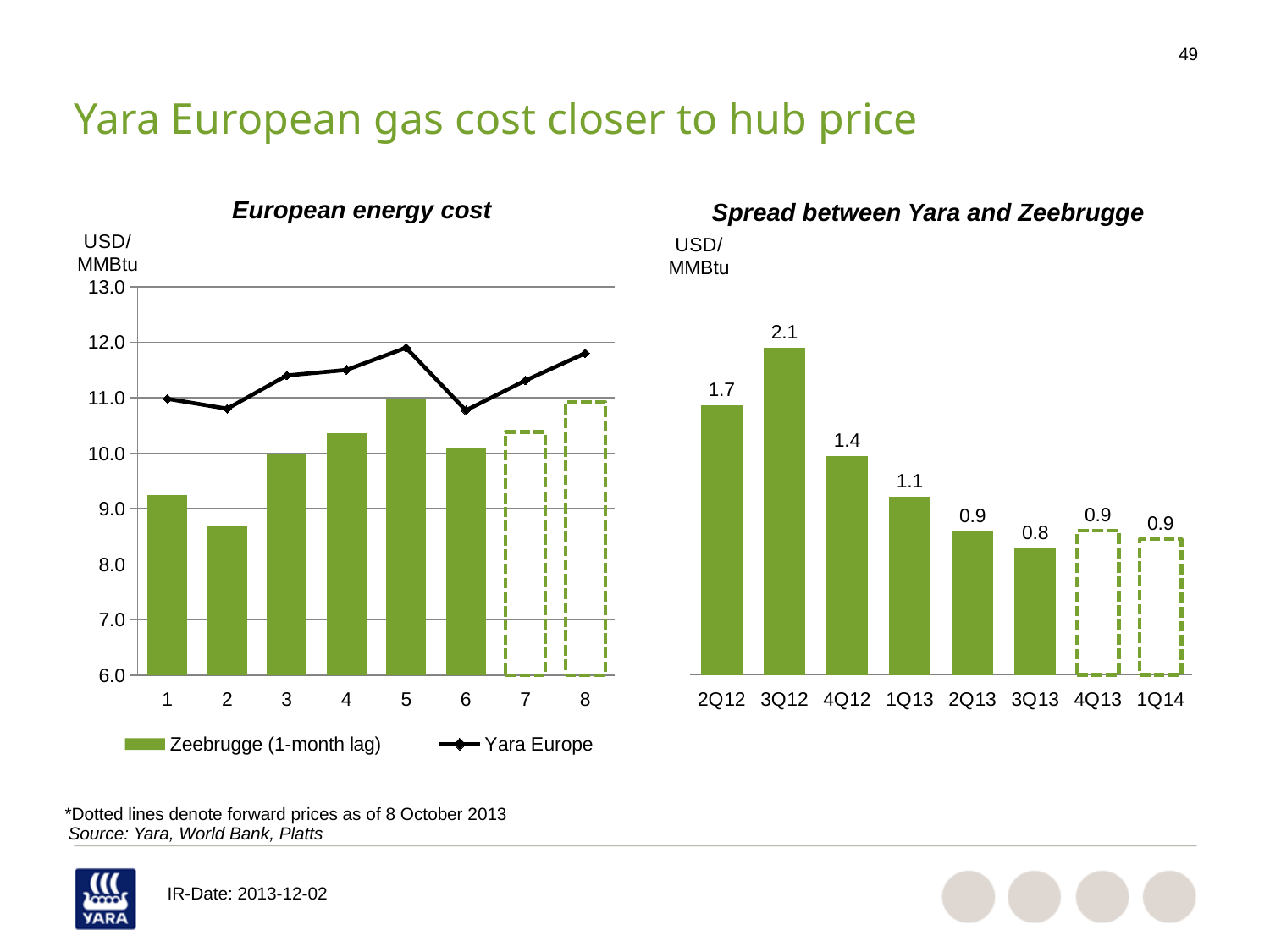
In the 'Spread between Yara and Zeebrugge' chart, which quarter has the highest spread? 3Q12 In the 'Spread between Yara and Zeebrugge' chart, what is the value for 1Q13? 1.1 In the 'European energy cost' chart, which series is drawn as a line with diamond markers? Yara Europe In the 'Spread between Yara and Zeebrugge' chart, what is the value for 3Q12? 2.1 In the 'Spread between Yara and Zeebrugge' chart, what is the difference between the values for 2Q12 and 4Q12? 0.3 In the 'European energy cost' chart, which category has the lowest Zeebrugge (1-month lag) value? 2 In the 'Spread between Yara and Zeebrugge' chart, do the values generally rise or fall from 3Q12 to 3Q13? fall In the 'Spread between Yara and Zeebrugge' chart, which quarter has the lowest spread? 3Q13 How many quarters are shown in the 'Spread between Yara and Zeebrugge' chart? 8 In the 'European energy cost' chart, is the Yara Europe value for category 5 greater or less than 11.0? greater In the 'European energy cost' chart, is the Zeebrugge (1-month lag) value for category 2 greater or less than 9.0? less How many series does the legend of the 'European energy cost' chart list? 2